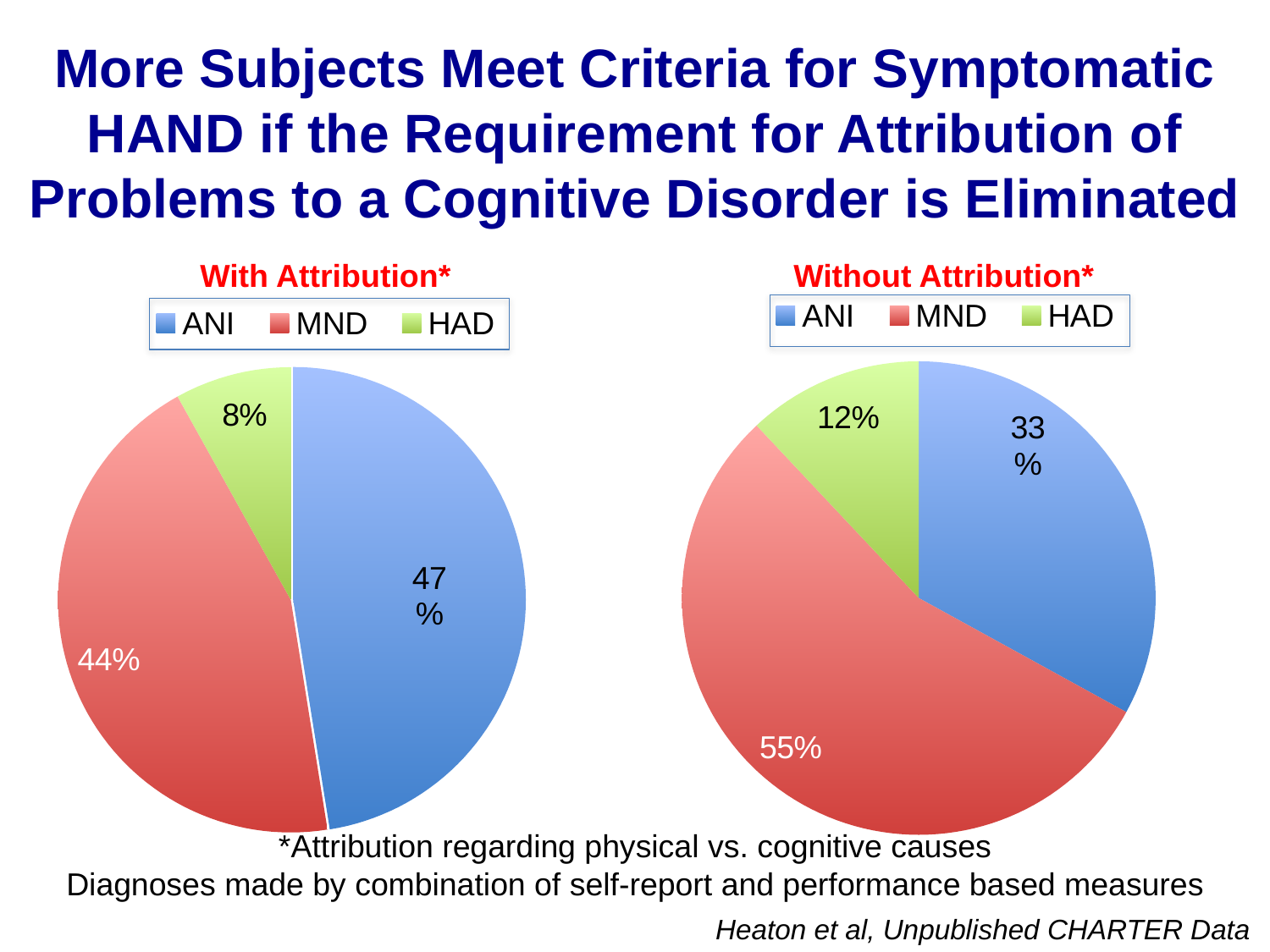
Is the ANI slice larger in the 'With Attribution*' chart or the 'Without Attribution*' chart? With Attribution* How many categories does the 'Without Attribution*' chart show? 3 In the 'With Attribution*' chart, what percentage is shown for MND? 44% In the 'With Attribution*' chart, which category has the largest slice? ANI What type of chart is the 'With Attribution*' chart? Pie chart In the 'With Attribution*' chart, what percentage is shown for ANI? 47% In the 'Without Attribution*' chart, what percentage is shown for HAD? 12% In the 'With Attribution*' chart, what colour represents HAD? Green In the 'Without Attribution*' chart, what percentage is shown for MND? 55% In the 'Without Attribution*' chart, which category has the largest slice? MND In the 'With Attribution*' chart, which category has the smallest slice? HAD What is the difference between the MND percentage in the 'Without Attribution*' chart and the MND percentage in the 'With Attribution*' chart? 11%